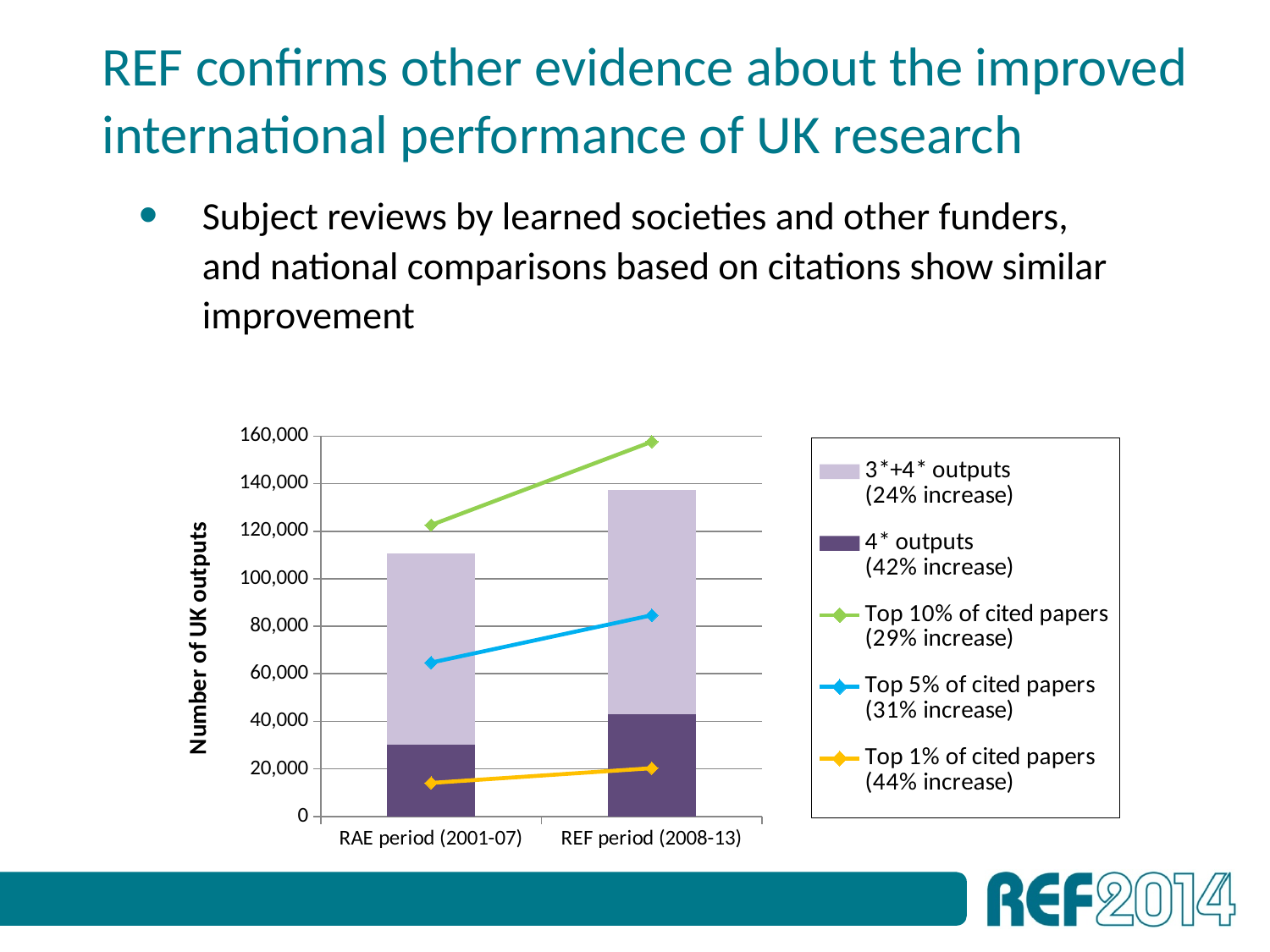
Does the Top 10% of cited papers line rise or fall from the RAE period to the REF period? Rise Is the value for Top 5% of cited papers in the RAE period (2001-07) greater or less than 80,000? less How many categories are shown on the x axis of the chart? 2 What kind of chart is shown on the slide? Combined stacked bar and line chart How many series does the chart's legend list? 5 In the REF period (2008-13), which is larger: Top 10% of cited papers or Top 5% of cited papers? Top 10% of cited papers What is the title of the chart's vertical axis? Number of UK outputs According to the legend, what percentage increase is given for 4* outputs? 42% increase Is the value for Top 10% of cited papers in the REF period (2008-13) greater or less than 140,000? greater Is the 4* outputs value in the RAE period (2001-07) greater or less than 20,000? greater